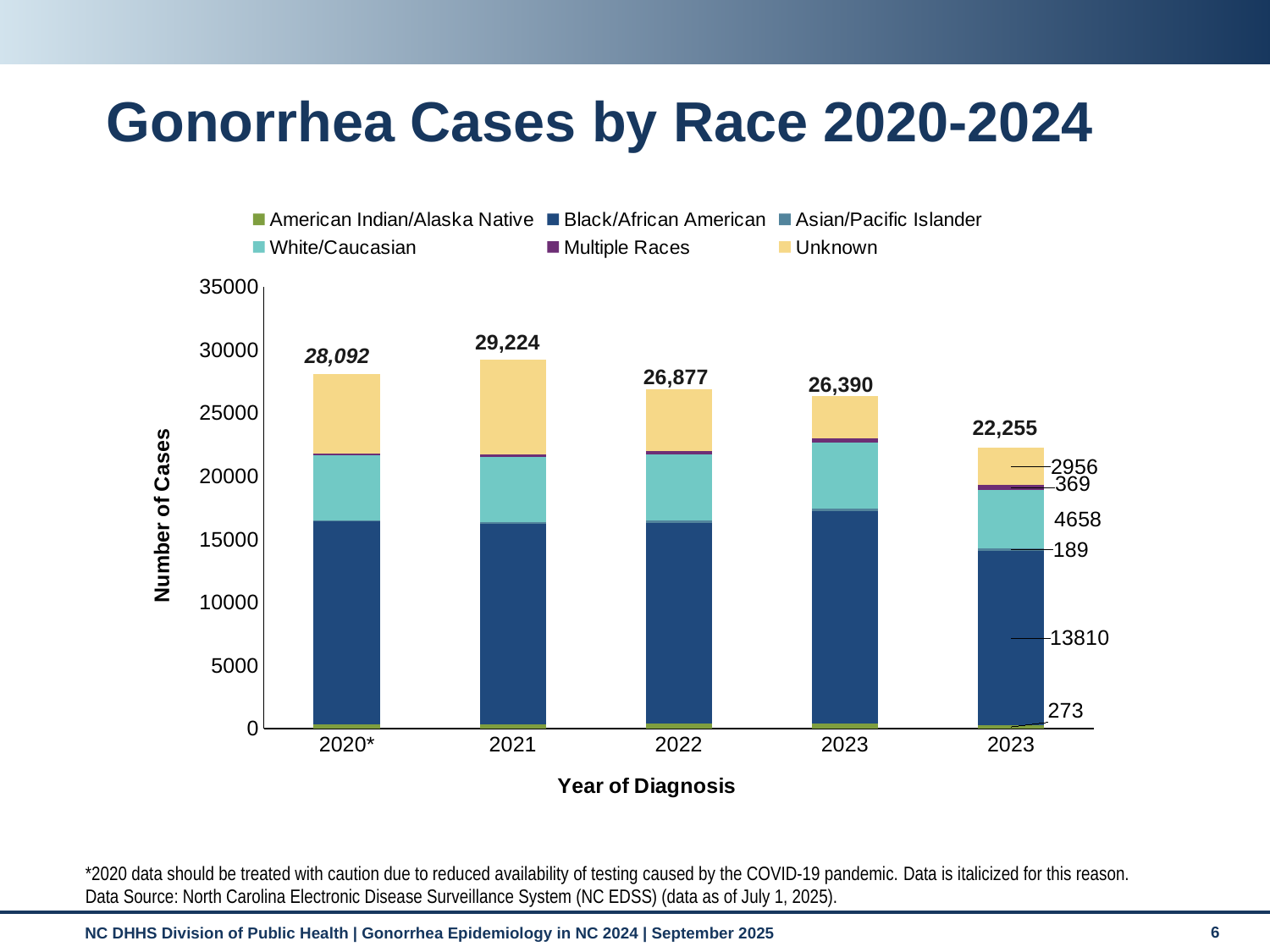
What is the lowest bar total shown on the chart? 22,255 How many series does the legend list? 6 In the rightmost bar, how many cases are labeled for the Black/African American segment? 13810 Which is larger, the total for 2022 or the total for the fourth bar (2023)? 2022 What kind of chart is shown on the slide? Stacked bar chart In the rightmost bar, how many cases are labeled for the Unknown segment? 2956 Which year has the highest total number of cases? 2021 What is the difference between the 2021 total and the 2020* total? 1,132 What is the total number of gonorrhea cases shown for 2021? 29,224 What is the total number of cases shown for the 2020* bar? 28,092 In the rightmost bar, how many cases are labeled for the White/Caucasian segment? 4658 Is the Black/African American segment in the fourth bar (2023) greater or less than 15000? greater